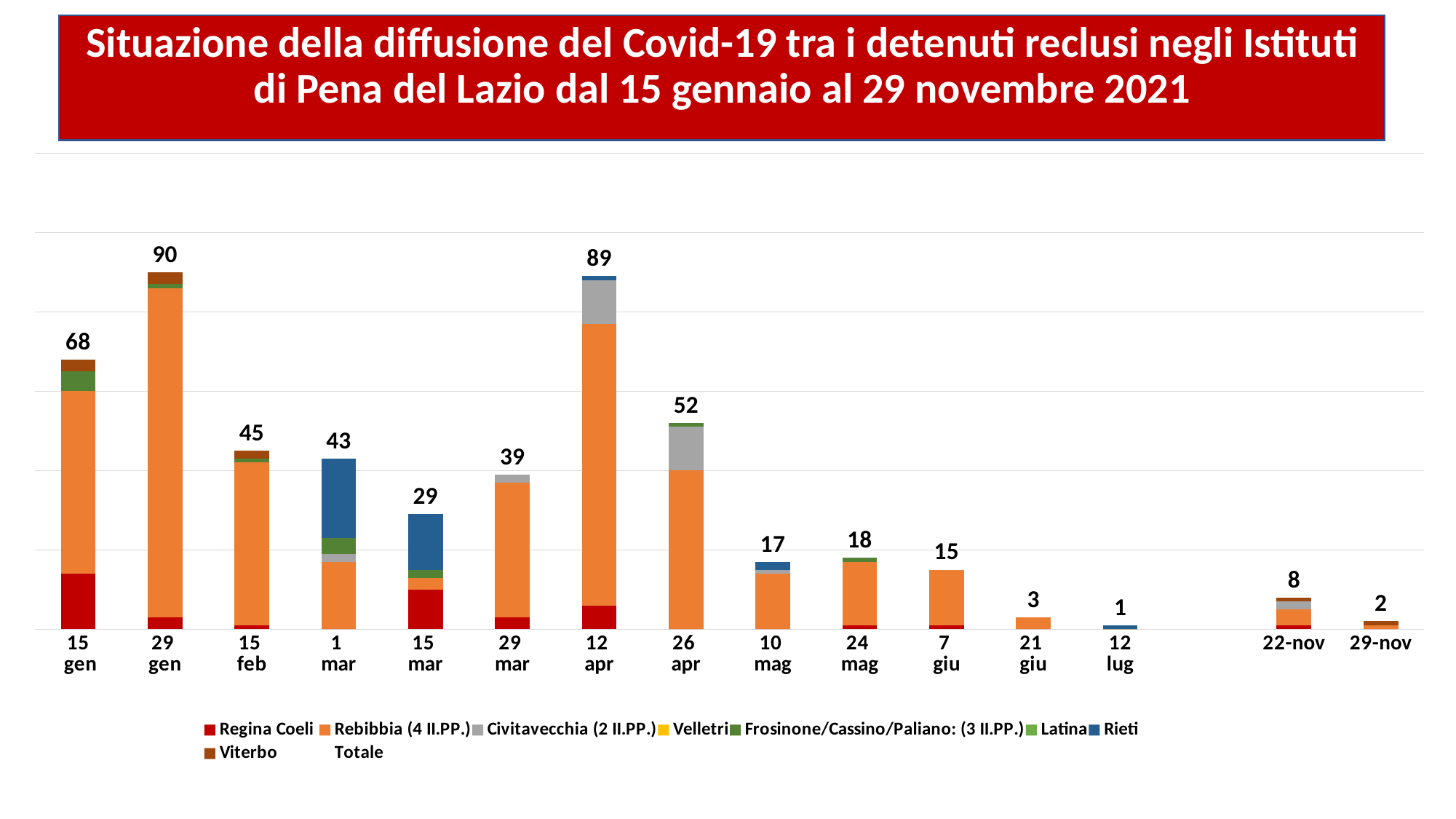
How many dates are shown on the x axis? 15 Do the totals rise or fall from 12 apr to 12 lug? Fall Which date has the highest total? 29 gen What is the total value shown for 22-nov? 8 Which institution does the orange segment represent according to the legend? Rebibbia (4 II.PP.) What is the total value shown for 29 gen? 90 How many entries does the legend list? 9 Which has a larger total, 1 mar or 26 apr? 26 apr Which date has the lowest total? 12 lug What is the total value shown for 12 apr? 89 What is the difference between the totals for 15 gen and 15 feb? 23 What kind of chart is shown on the slide? Stacked bar chart